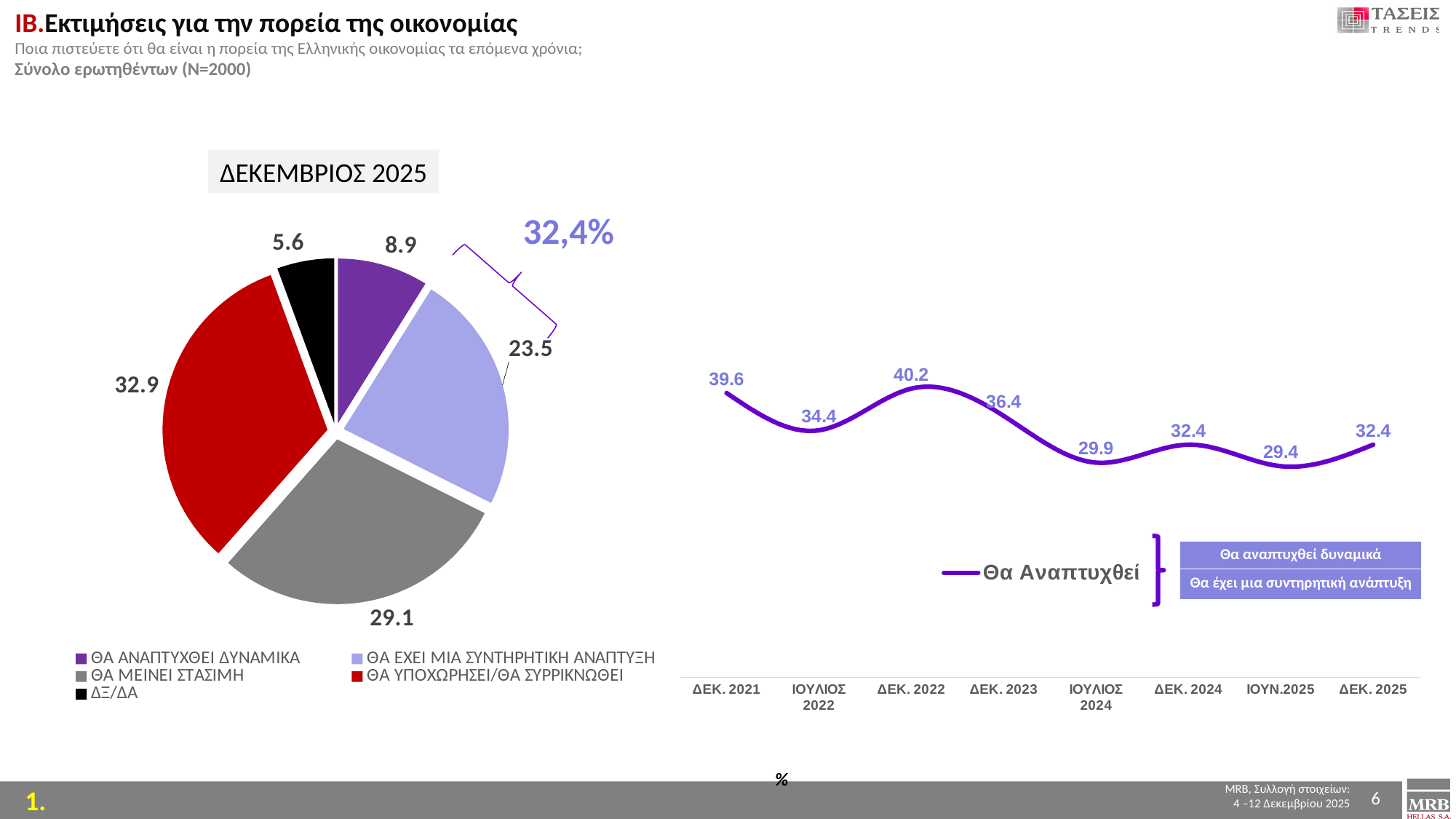
In the pie chart titled ΔΕΚΕΜΒΡΙΟΣ 2025, which category has the largest slice? ΘΑ ΥΠΟΧΩΡΗΣΕΙ/ΘΑ ΣΥΡΡΙΚΝΩΘΕΙ In the line chart on the right, what is the value for ΙΟΥΝ.2025? 29.4 In the pie chart titled ΔΕΚΕΜΒΡΙΟΣ 2025, what is the difference between ΘΑ ΜΕΙΝΕΙ ΣΤΑΣΙΜΗ and ΘΑ ΑΝΑΠΤΥΧΘΕΙ ΔΥΝΑΜΙΚΑ? 20.2 What type of chart is the chart on the right side of the slide? Line chart In the line chart on the right, which time point has the highest value? ΔΕΚ. 2022 In the pie chart titled ΔΕΚΕΜΒΡΙΟΣ 2025, which category has the smallest slice? ΔΞ/ΔΑ In the pie chart titled ΔΕΚΕΜΒΡΙΟΣ 2025, what is the value for ΘΑ ΥΠΟΧΩΡΗΣΕΙ/ΘΑ ΣΥΡΡΙΚΝΩΘΕΙ? 32.9 In the line chart on the right, what is the value for ΔΕΚ. 2022? 40.2 How many categories does the pie chart titled ΔΕΚΕΜΒΡΙΟΣ 2025 show? 5 In the pie chart titled ΔΕΚΕΜΒΡΙΟΣ 2025, what is the value for ΘΑ ΕΧΕΙ ΜΙΑ ΣΥΝΤΗΡΗΤΙΚΗ ΑΝΑΠΤΥΞΗ? 23.5 In the line chart on the right, what is the difference between the values for ΔΕΚ. 2021 and ΔΕΚ. 2025? 7.2 In the line chart on the right, which time point has the lowest value? ΙΟΥΝ.2025